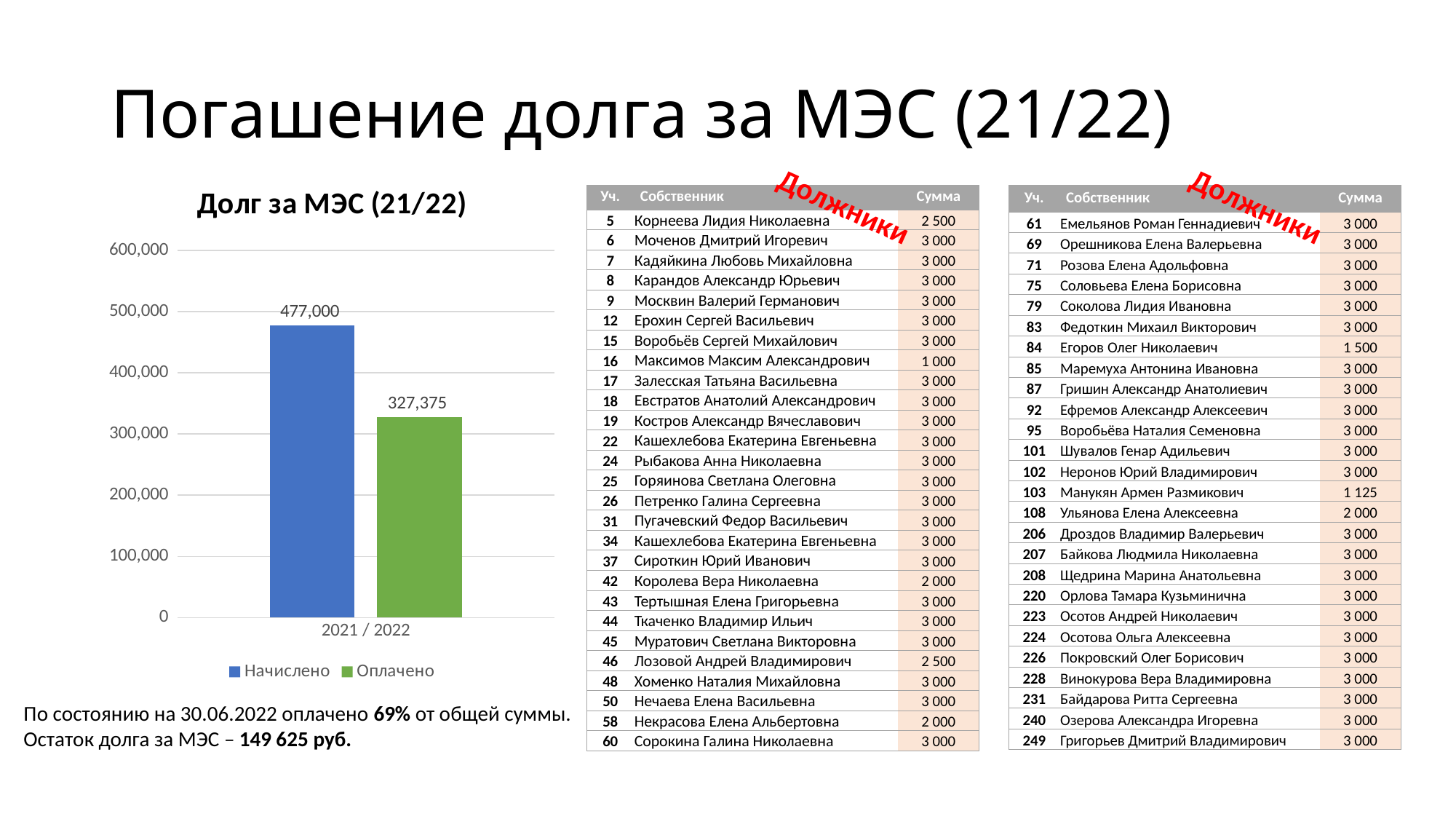
How many series does the chart legend list? 2 Which series has the higher value, Начислено or Оплачено? Начислено What is the value of Оплачено for 2021 / 2022? 327,375 Which series is shown in green in the chart? Оплачено Is the value for Оплачено greater or less than 300,000? greater What is the category label on the x axis of the chart? 2021 / 2022 What is the title of the chart? Долг за МЭС (21/22) What type of chart is shown on the slide? bar chart What is the value of Начислено for 2021 / 2022? 477,000 What is the difference between Начислено and Оплачено for 2021 / 2022? 149,625 Is the value for Начислено greater or less than 500,000? less How many categories are shown on the x axis of the chart? 1